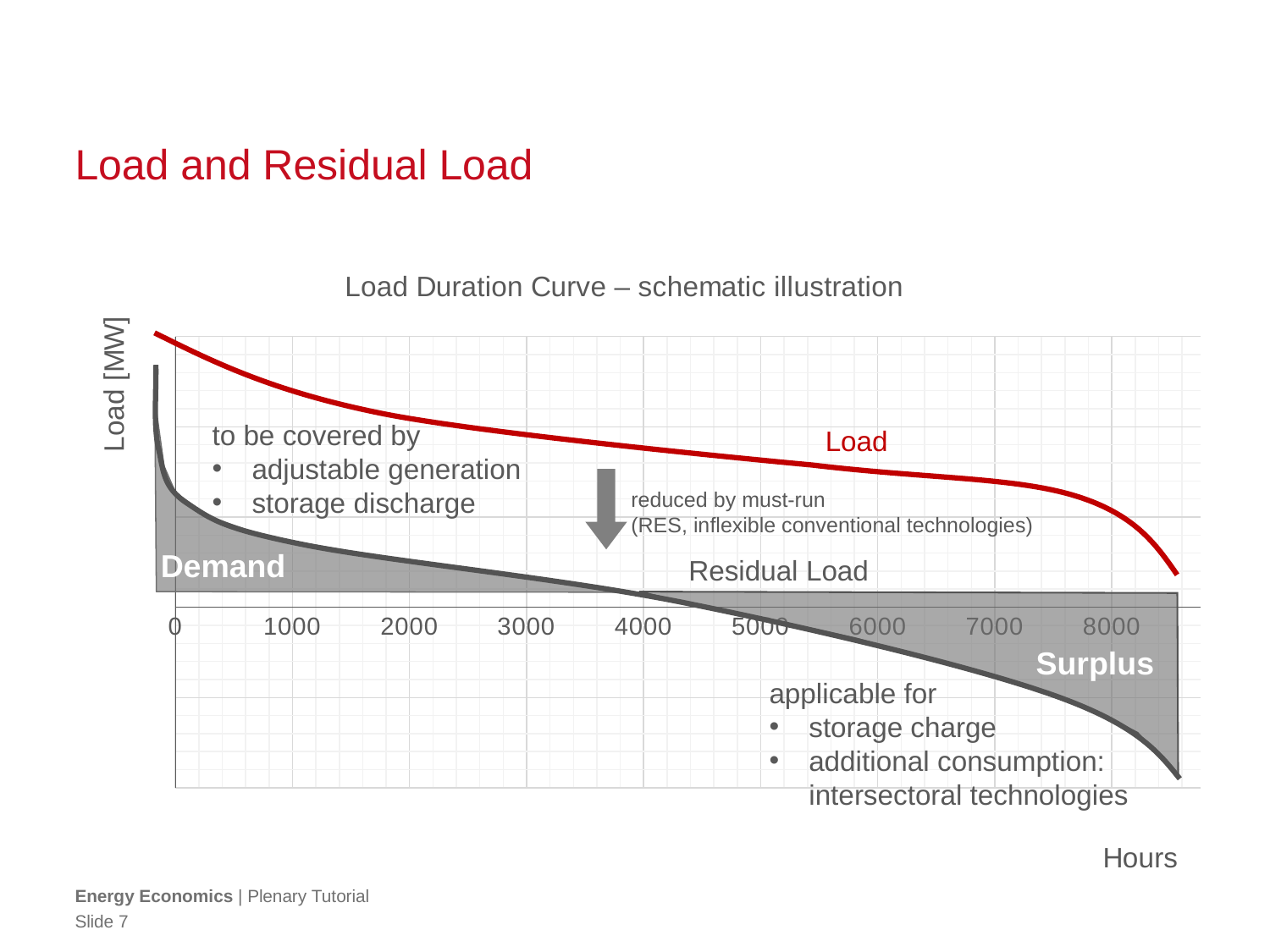
Does the Load curve rise or fall as the hours increase along the x axis? fall What is the label of the vertical axis? Load [MW] What is the title of the chart? Load Duration Curve – schematic illustration At 7000 hours, which curve has the lower value, Load or Residual Load? Residual Load How many labelled tick values are shown on the x axis? 9 How many curves are plotted on the chart? 2 Which curve is drawn in red, Load or Residual Load? Load At 2000 hours, which curve has the higher value, Load or Residual Load? Load Does the Residual Load curve rise or fall as the hours increase along the x axis? fall What kind of chart is shown on the slide? line chart What is the lowest tick value shown on the x axis? 0 What is the highest tick value shown on the x axis? 8000